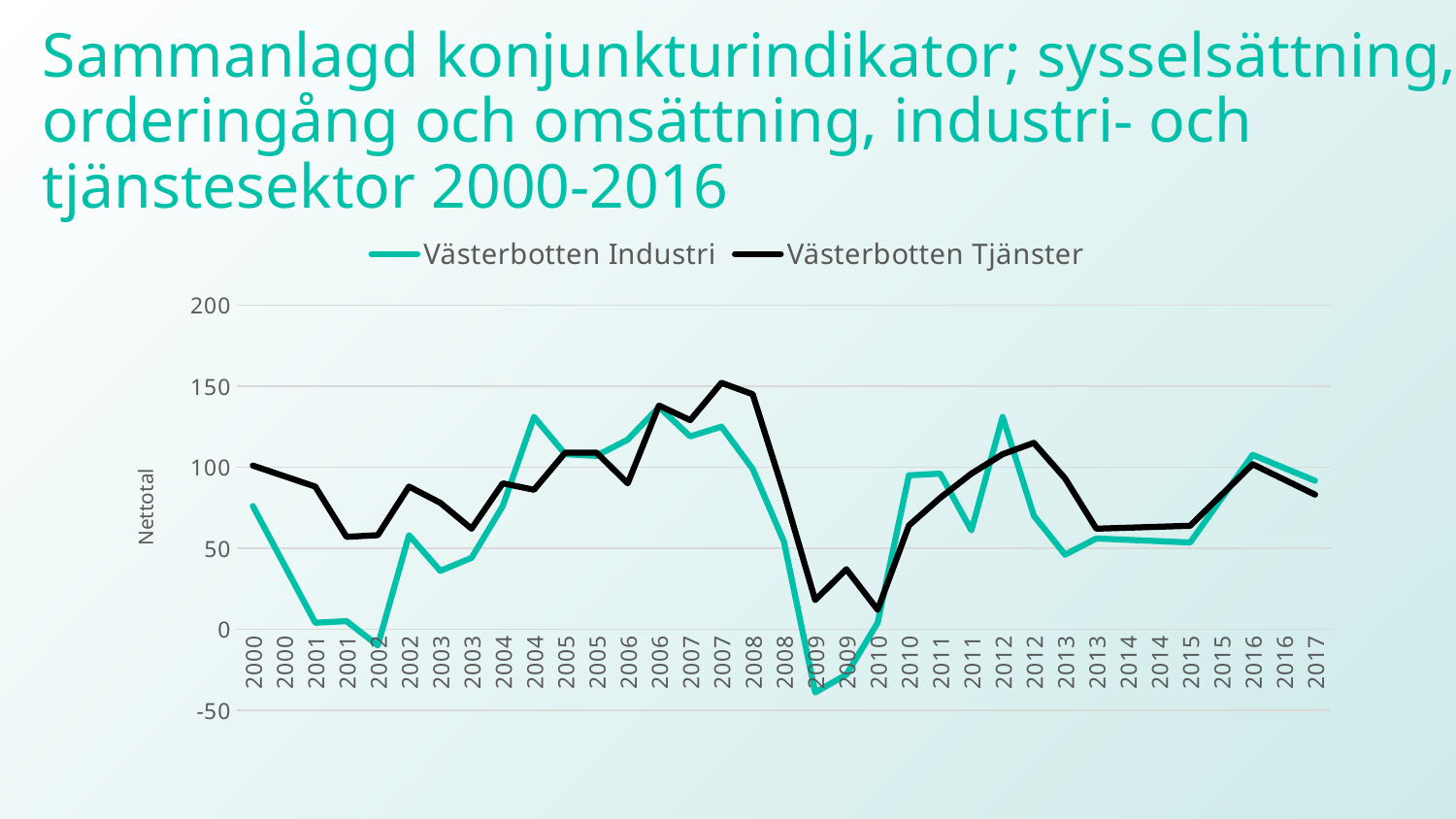
At the first 2012 point, which series has the higher value, Västerbotten Industri or Västerbotten Tjänster? Västerbotten Industri Is the value for Västerbotten Tjänster at the first 2009 point greater or less than 50? less Is the value for Västerbotten Tjänster at the second 2007 point greater or less than 100? greater Is the value for Västerbotten Industri at the first 2009 point greater or less than 0? less What are the two series named in the legend? Västerbotten Industri and Västerbotten Tjänster How many series does the legend list? 2 What kind of chart is shown on the slide? Line chart At the first 2001 point, which series has the higher value, Västerbotten Industri or Västerbotten Tjänster? Västerbotten Tjänster What is the label on the vertical axis? Nettotal Does the Västerbotten Industri line rise or fall between the first 2000 point and the first 2001 point? Fall Does the Västerbotten Tjänster line rise or fall between the second 2007 point and the first 2009 point? Fall